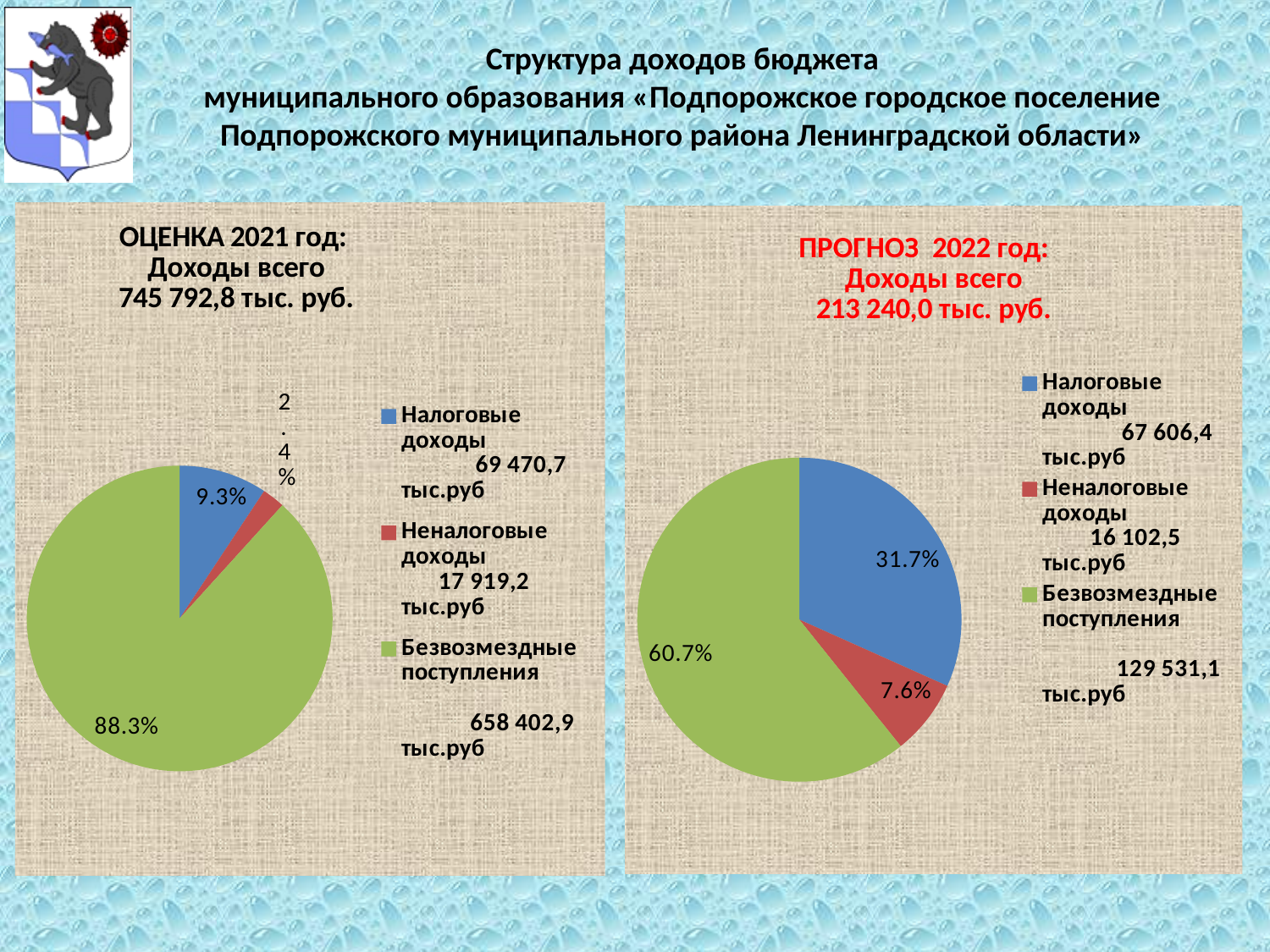
In the right pie chart (ПРОГНОЗ 2022 год), what share is shown for Безвозмездные поступления? 60.7% In the left pie chart (ОЦЕНКА 2021 год), what share is shown for Налоговые доходы? 9.3% In the left pie chart (ОЦЕНКА 2021 год), what share is shown for Неналоговые доходы? 2.4% What type of chart is used on the left (ОЦЕНКА 2021 год) side of the slide? pie chart In the right pie chart (ПРОГНОЗ 2022 год), what is the difference in percentage points between the Безвозмездные поступления slice and the Налоговые доходы slice? 29.0 percentage points In the left chart (ОЦЕНКА 2021 год), what value in тыс.руб is given in the legend for Неналоговые доходы? 17 919,2 тыс.руб In the left pie chart (ОЦЕНКА 2021 год), which category has the largest slice? Безвозмездные поступления In the right chart (ПРОГНОЗ 2022 год), what value in тыс.руб is given in the legend for Налоговые доходы? 67 606,4 тыс.руб In the right pie chart (ПРОГНОЗ 2022 год), which category has the smallest slice? Неналоговые доходы How many categories does the legend of the right pie chart (ПРОГНОЗ 2022 год) list? 3